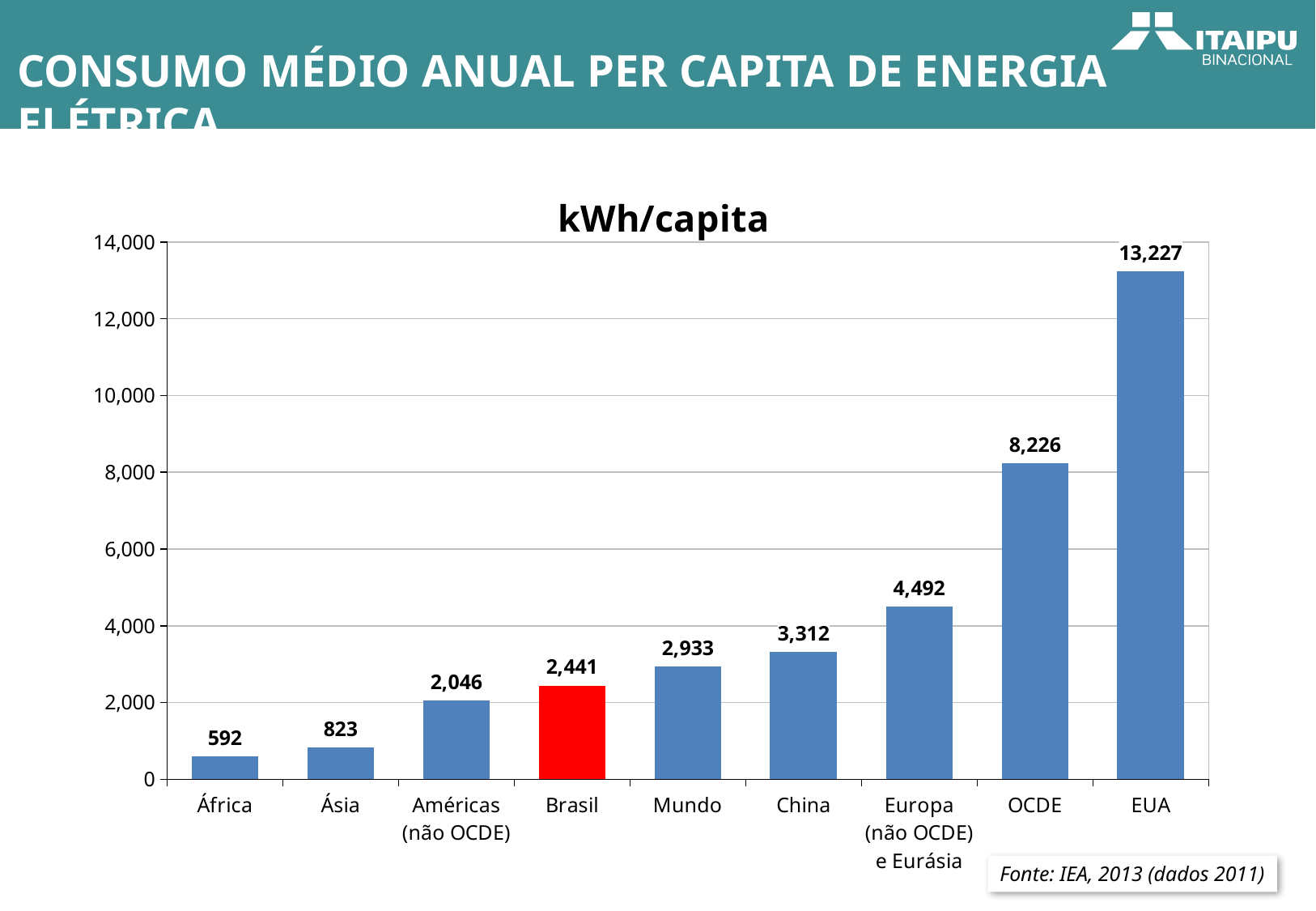
What is the value for Mundo? 2,933 What kind of chart is shown on the slide? bar chart Which category has the lowest value? África Which bar is coloured red? Brasil What is the difference between the values for EUA and OCDE? 5,001 What is the value for Brasil? 2,441 Which category has the highest value? EUA What is the difference between the values for Brasil and Mundo? 492 How many categories are shown on the x axis? 9 Which is larger, the value for China or the value for Brasil? China What is the value for OCDE? 8,226 Is the value for Europa (não OCDE) e Eurásia greater or less than 4,000? greater